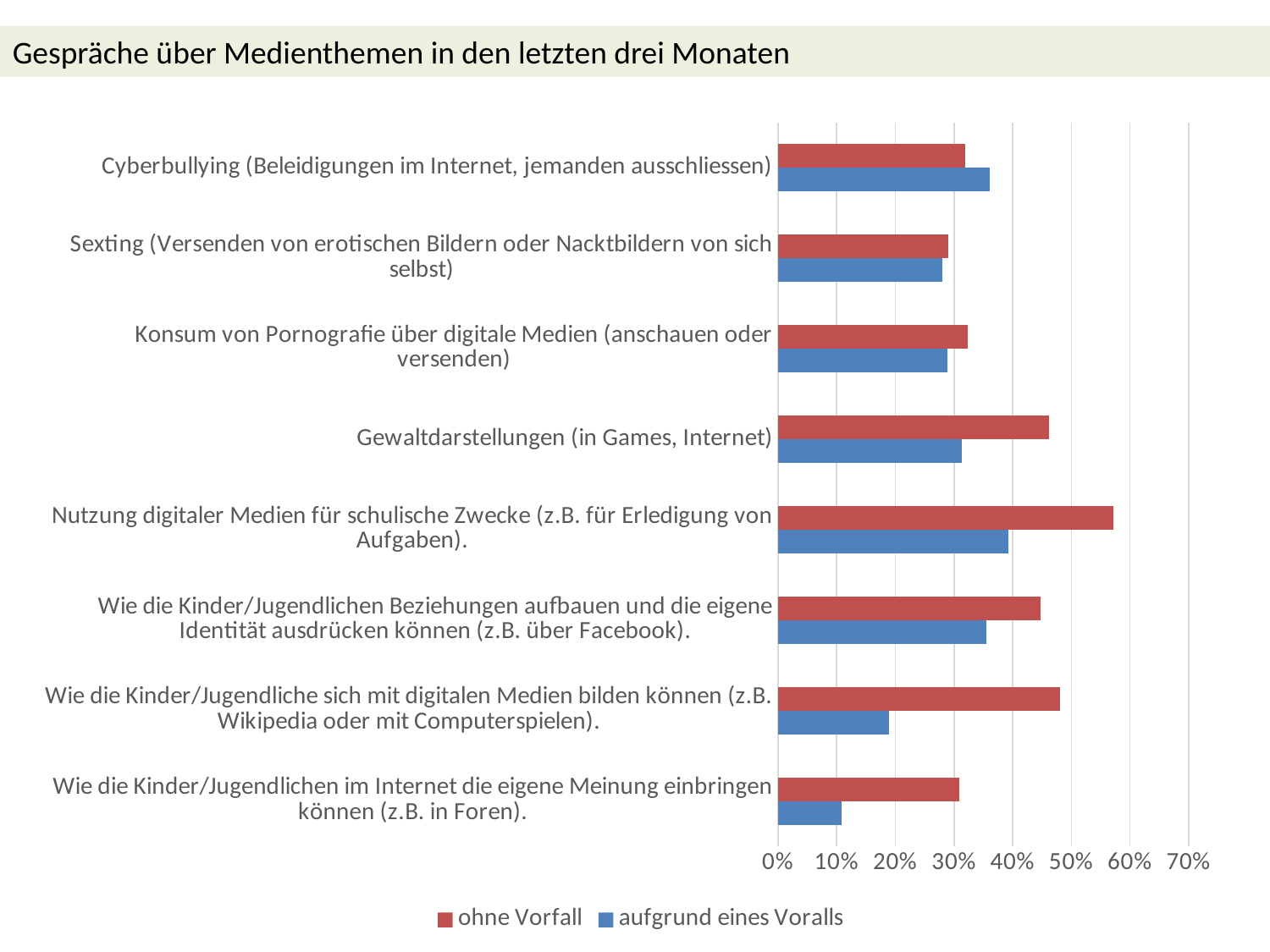
Is the "aufgrund eines Voralls" value for "Wie die Kinder/Jugendlichen im Internet die eigene Meinung einbringen können" greater or less than 20%? less Is the "ohne Vorfall" value for "Gewaltdarstellungen (in Games, Internet)" greater or less than 40%? greater How many categories (topics) are plotted in the chart? 8 What is the title of the chart on the slide? Gespräche über Medienthemen in den letzten drei Monaten What kind of chart is shown on the slide? bar chart Is the "ohne Vorfall" value for "Nutzung digitaler Medien für schulische Zwecke" greater or less than 50%? greater How many series does the legend list? 2 For "Wie die Kinder/Jugendliche sich mit digitalen Medien bilden können", which series has the larger value, "ohne Vorfall" or "aufgrund eines Voralls"? ohne Vorfall For "Cyberbullying", which series has the larger value, "ohne Vorfall" or "aufgrund eines Voralls"? aufgrund eines Voralls Which category has the lowest value for the series "aufgrund eines Voralls"? Wie die Kinder/Jugendlichen im Internet die eigene Meinung einbringen können (z.B. in Foren). Which category has the highest value for the series "ohne Vorfall"? Nutzung digitaler Medien für schulische Zwecke (z.B. für Erledigung von Aufgaben).